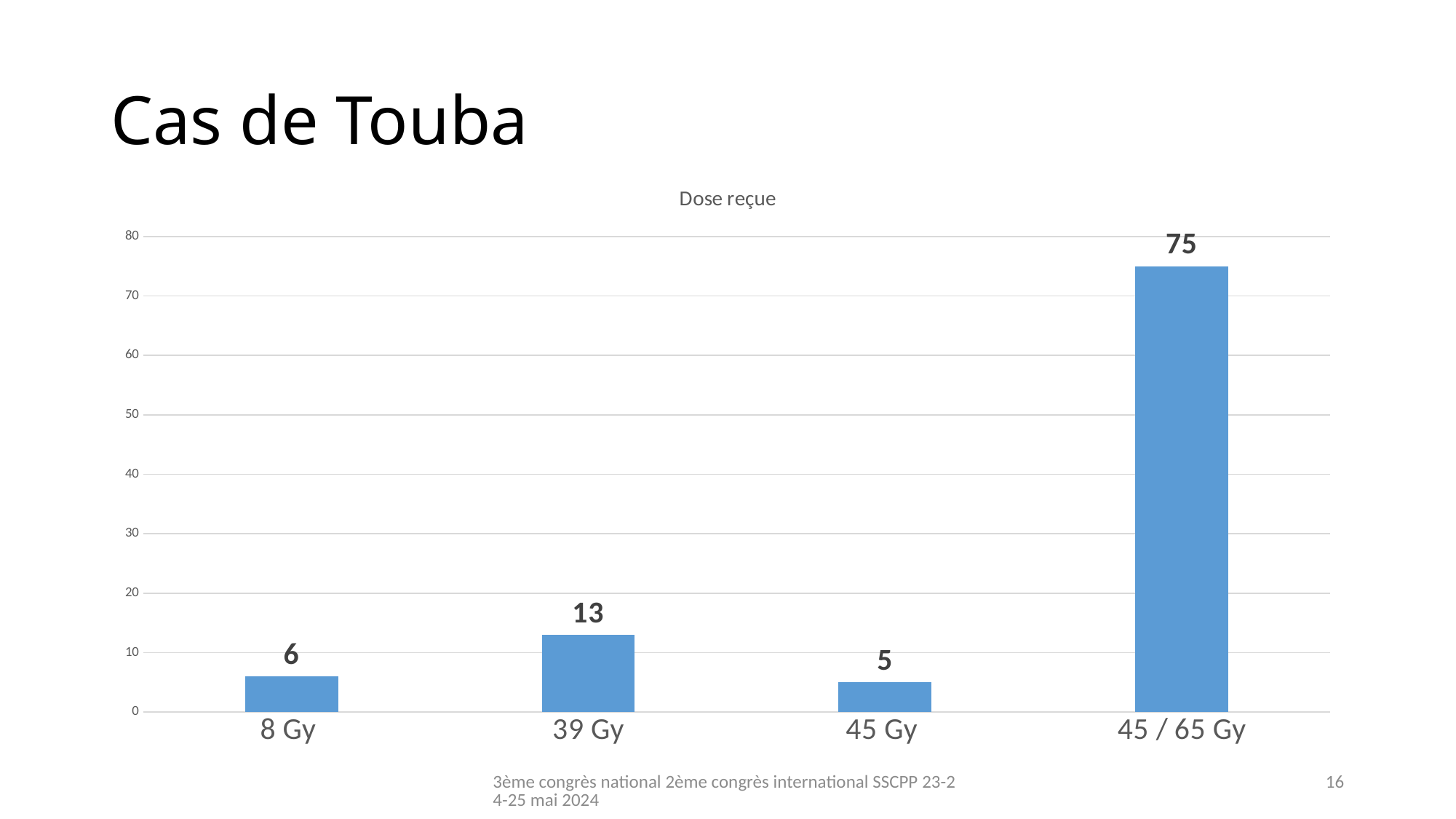
What is the value for 45 Gy? 5 What kind of chart is shown on the slide? bar chart What is the value for 45 / 65 Gy? 75 Which category has the lowest value? 45 Gy What is the value for 39 Gy? 13 Which is larger, the value for 39 Gy or the value for 8 Gy? 39 Gy Is the value for 45 / 65 Gy greater or less than 70? greater What is the difference between the values for 45 / 65 Gy and 39 Gy? 62 How many categories are shown on the x axis? 4 What is the value for 8 Gy? 6 Which category has the highest value? 45 / 65 Gy What is the difference between the values for 8 Gy and 45 Gy? 1